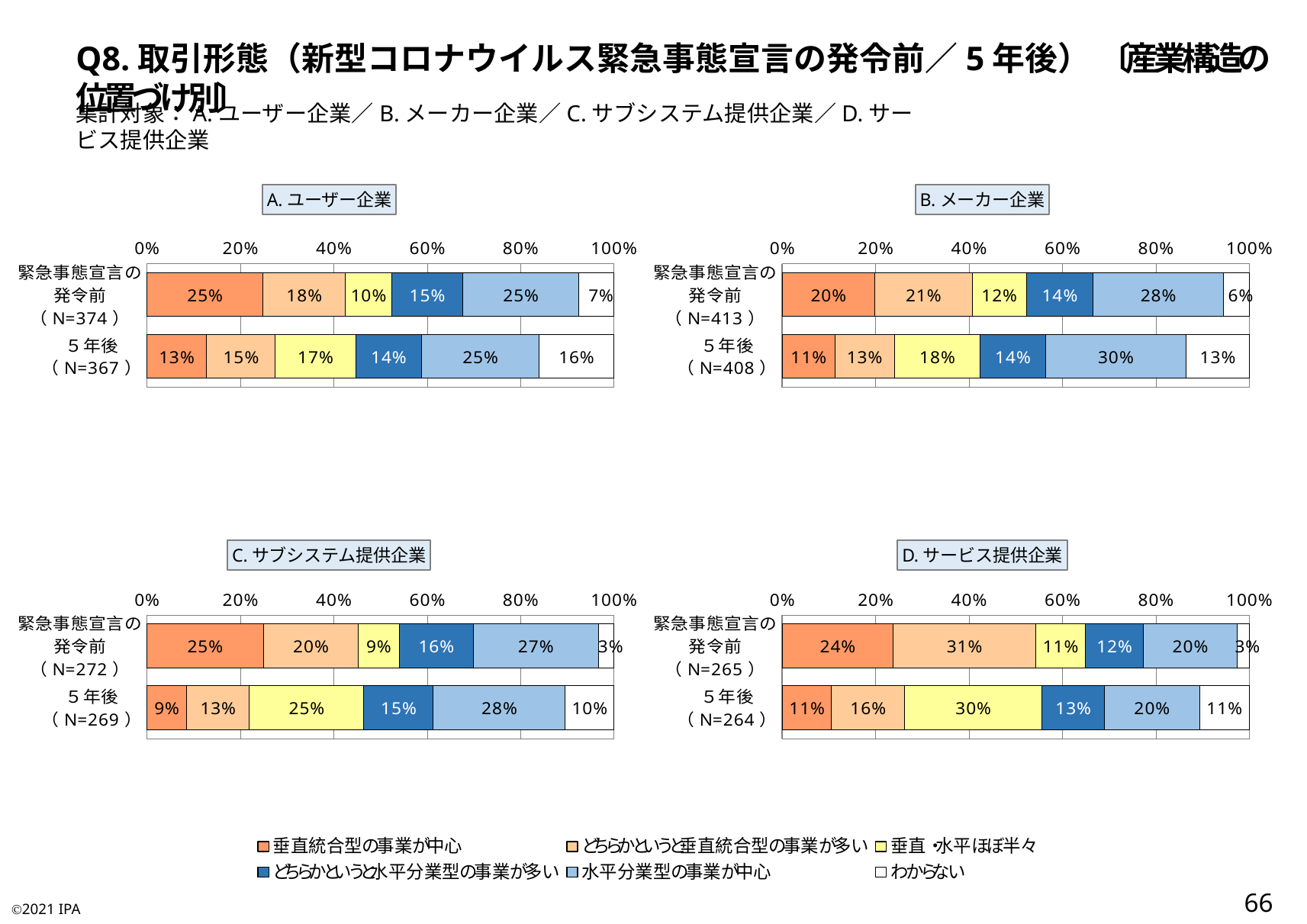
In the chart titled 'D. サービス提供企業', which series has the highest value for 5年後? 垂直・水平ほぼ半々 How many categories (bars) are shown in the chart titled 'A. ユーザー企業'? 2 In the chart titled 'B. メーカー企業', which series has the lowest value for 緊急事態宣言の発令前? わからない In the chart titled 'A. ユーザー企業', what is the difference between the 垂直統合型の事業が中心 values for 緊急事態宣言の発令前 and 5年後? 12% How many series does the legend list? 6 What kind of chart is the chart titled 'C. サブシステム提供企業'? Stacked bar chart In the chart titled 'C. サブシステム提供企業', what is the value of わからない for 5年後? 10% In the chart titled 'A. ユーザー企業', what is the value of 垂直統合型の事業が中心 for 緊急事態宣言の発令前? 25% In the chart titled 'B. メーカー企業', what is the difference between the わからない values for 5年後 and 緊急事態宣言の発令前? 7% In the chart titled 'B. メーカー企業', what is the value of 水平分業型の事業が中心 for 5年後? 30% In the chart titled 'C. サブシステム提供企業', which is larger for 5年後: 垂直・水平ほぼ半々 or どちらかというと垂直統合型の事業が多い? 垂直・水平ほぼ半々 In the chart titled 'D. サービス提供企業', what is the value of どちらかというと垂直統合型の事業が多い for 緊急事態宣言の発令前? 31%